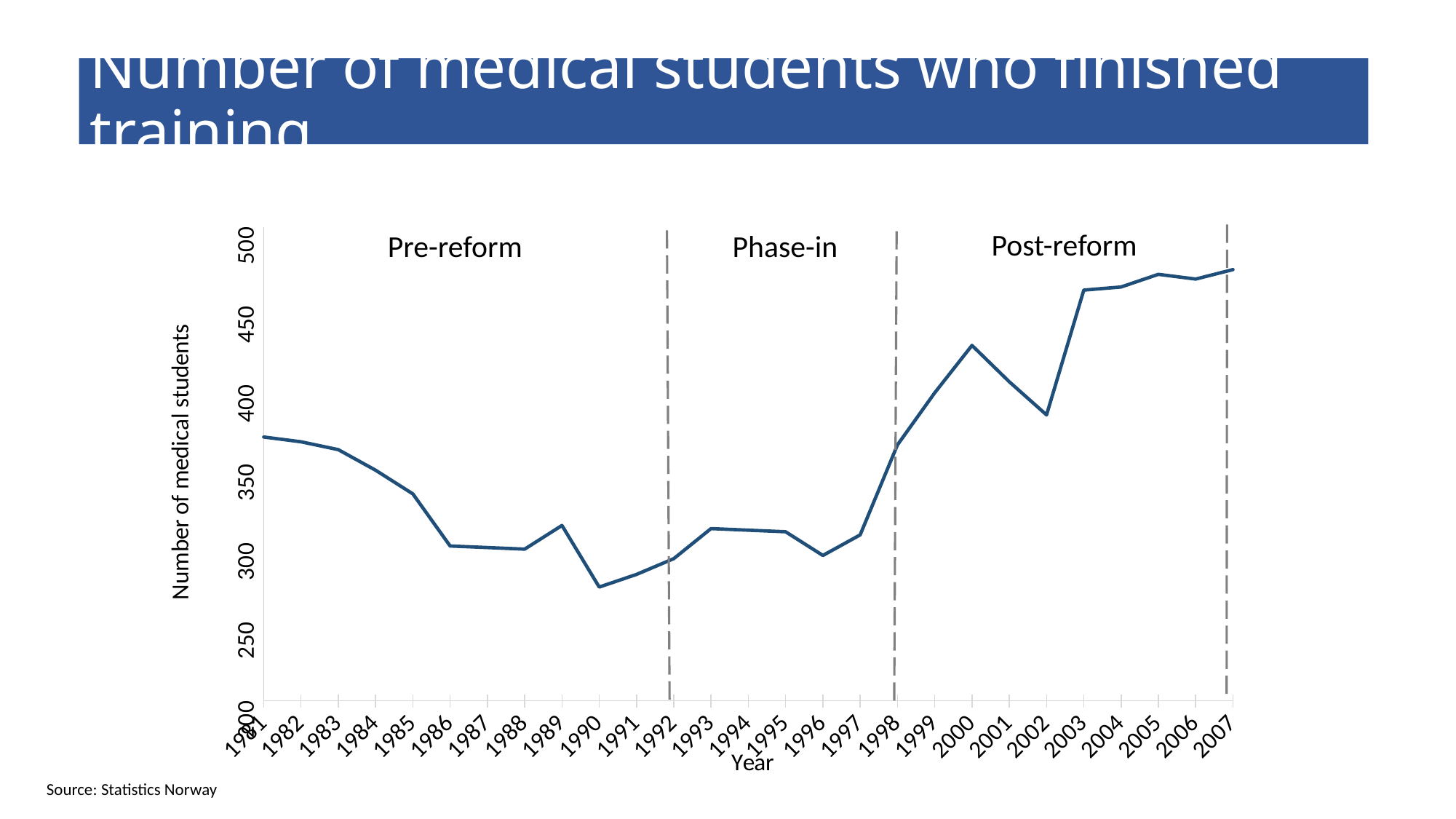
How many years are plotted along the x axis? 27 Is the value for 2003 greater or less than 450? greater Which year has the larger value, 1981 or 1990? 1981 What are the three periods labelled on the chart? Pre-reform, Phase-in, Post-reform Is the value for 1990 greater or less than 300? less Is the value for 2007 greater or less than 500? less Do the values rise or fall from 1981 to 1986? fall What kind of chart is shown on the slide? line chart Which year has the lowest number of medical students who finished training? 1990 Do the values rise or fall from 1997 to 2000? rise